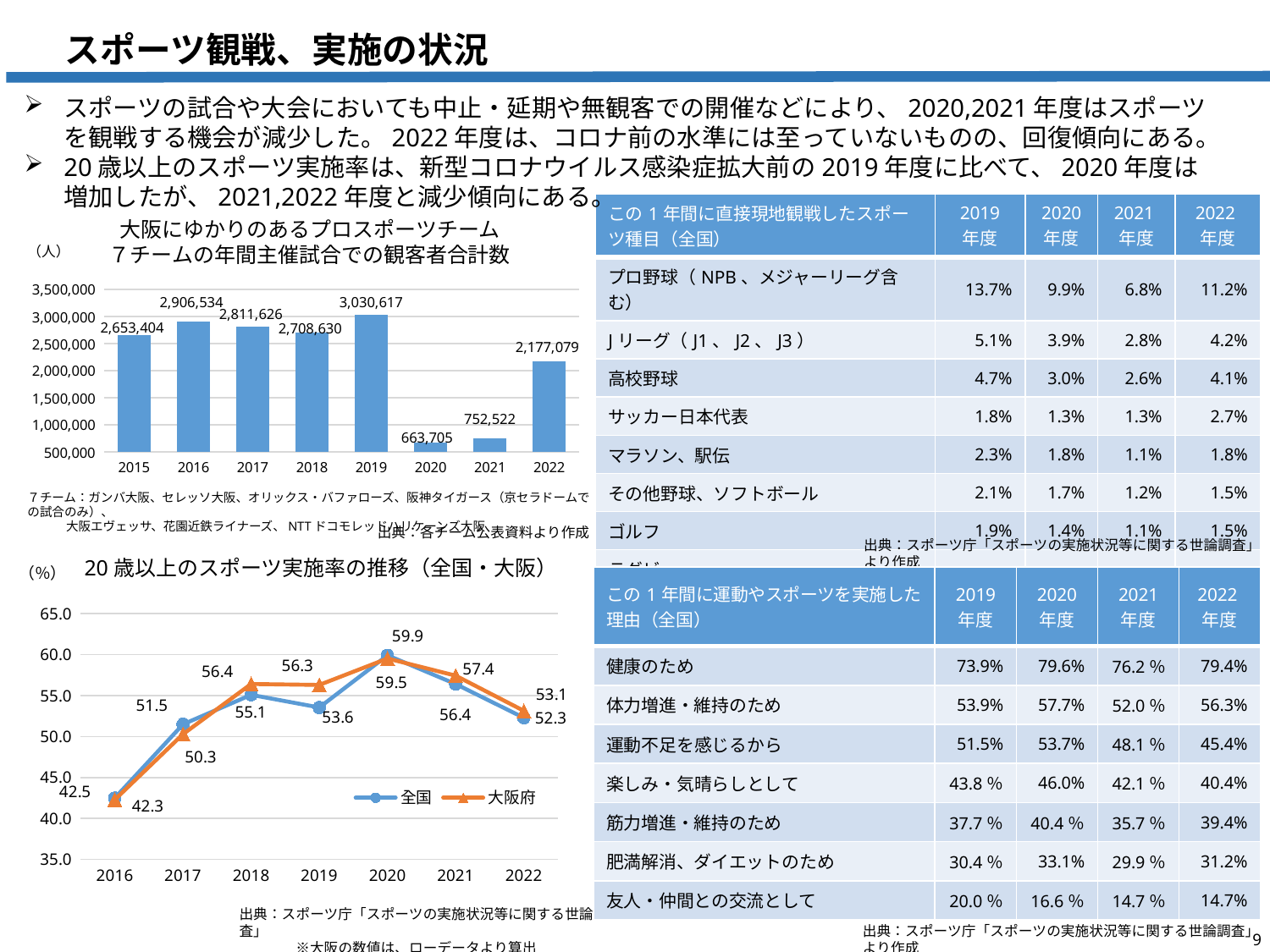
「20歳以上のスポーツ実施率の推移（全国・大阪）」のグラフで、2022年の大阪府と全国の値の差はいくらですか？ 0.8 「大阪にゆかりのあるプロスポーツチーム7チームの年間主催試合での観客者合計数」のグラフで、観客者合計数が最も多い年はどれですか？ 2019 「大阪にゆかりのあるプロスポーツチーム7チームの年間主催試合での観客者合計数」のグラフには何年分のデータがありますか？ 8 「大阪にゆかりのあるプロスポーツチーム7チームの年間主催試合での観客者合計数」のグラフで、観客者合計数が最も少ない年はどれですか？ 2020 「20歳以上のスポーツ実施率の推移（全国・大阪）」のグラフで、2017年の大阪府の値はいくらですか？ 50.3 「大阪にゆかりのあるプロスポーツチーム7チームの年間主催試合での観客者合計数」のグラフは何種類のグラフですか？ 棒グラフ 「大阪にゆかりのあるプロスポーツチーム7チームの年間主催試合での観客者合計数」のグラフで、2019年の観客者合計数はいくらですか？ 3,030,617 「大阪にゆかりのあるプロスポーツチーム7チームの年間主催試合での観客者合計数」のグラフで、2021年と2020年の観客者合計数の差はいくらですか？ 88,817 「20歳以上のスポーツ実施率の推移（全国・大阪）」のグラフで、2020年から2022年にかけて全国の値は上昇していますか、下降していますか？ 下降 「20歳以上のスポーツ実施率の推移（全国・大阪）」のグラフで、2019年は全国と大阪府のどちらの値が大きいですか？ 大阪府 「20歳以上のスポーツ実施率の推移（全国・大阪）」のグラフの凡例には何系列ありますか？ 2 「20歳以上のスポーツ実施率の推移（全国・大阪）」のグラフで、2020年の全国の値はいくらですか？ 59.9